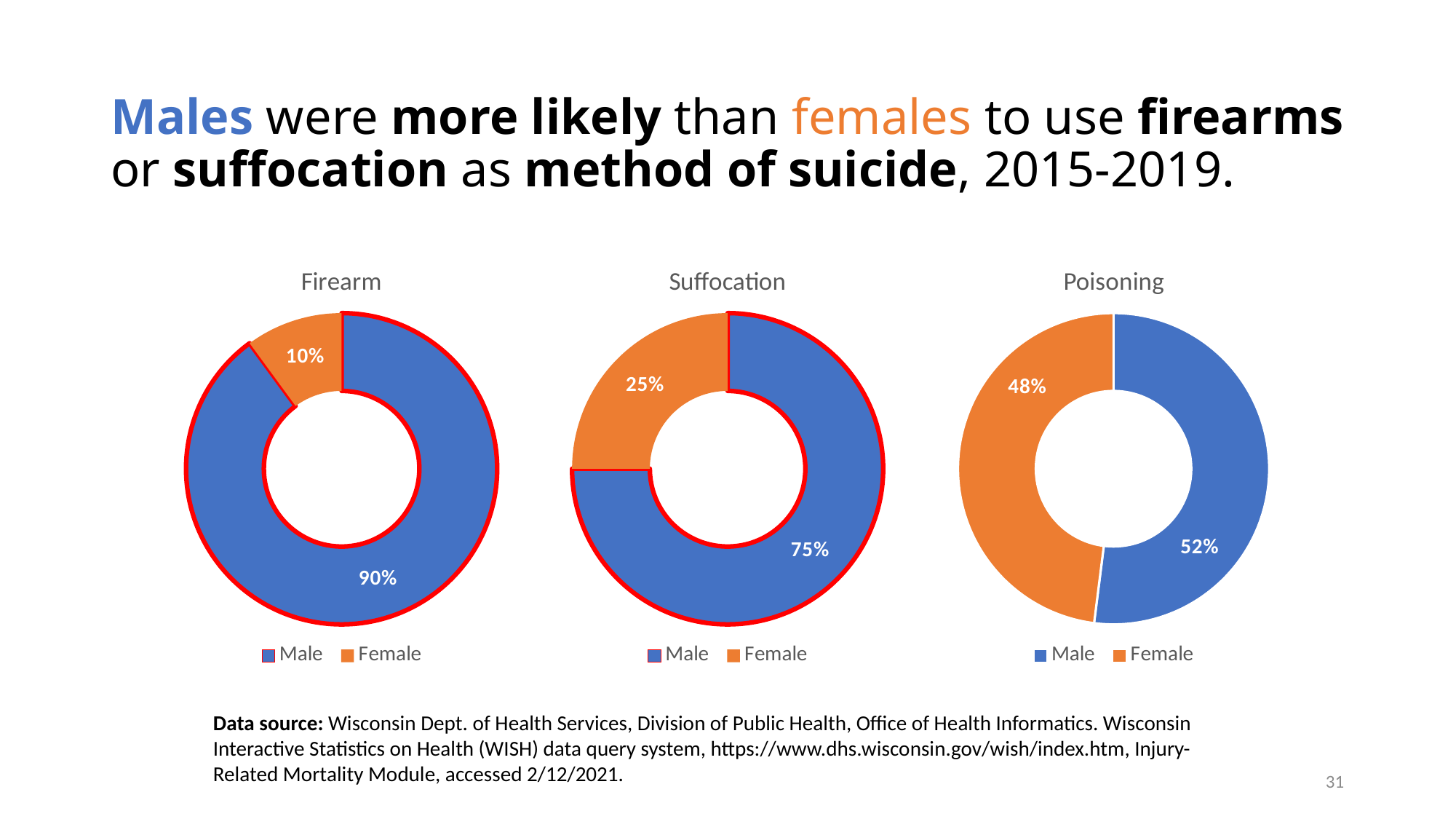
What kind of chart is the Firearm chart? Donut (pie) chart In the Poisoning chart, what is the difference between the Male and Female shares? 4% In the Suffocation chart, what is the difference between the Male and Female shares? 50% How many series does the legend of the Poisoning chart list? 2 In the Firearm chart, what share of the donut is Male? 90% In the Suffocation chart, which slice is larger, Male or Female? Male In the Poisoning chart, what share of the donut is Male? 52% In the Suffocation chart, what share of the donut is Female? 25% How many donut charts are shown on the slide? 3 In the Poisoning chart, what share of the donut is Female? 48% In the Firearm chart, what share of the donut is Female? 10% In the Firearm chart, what is the difference between the Male and Female shares? 80%